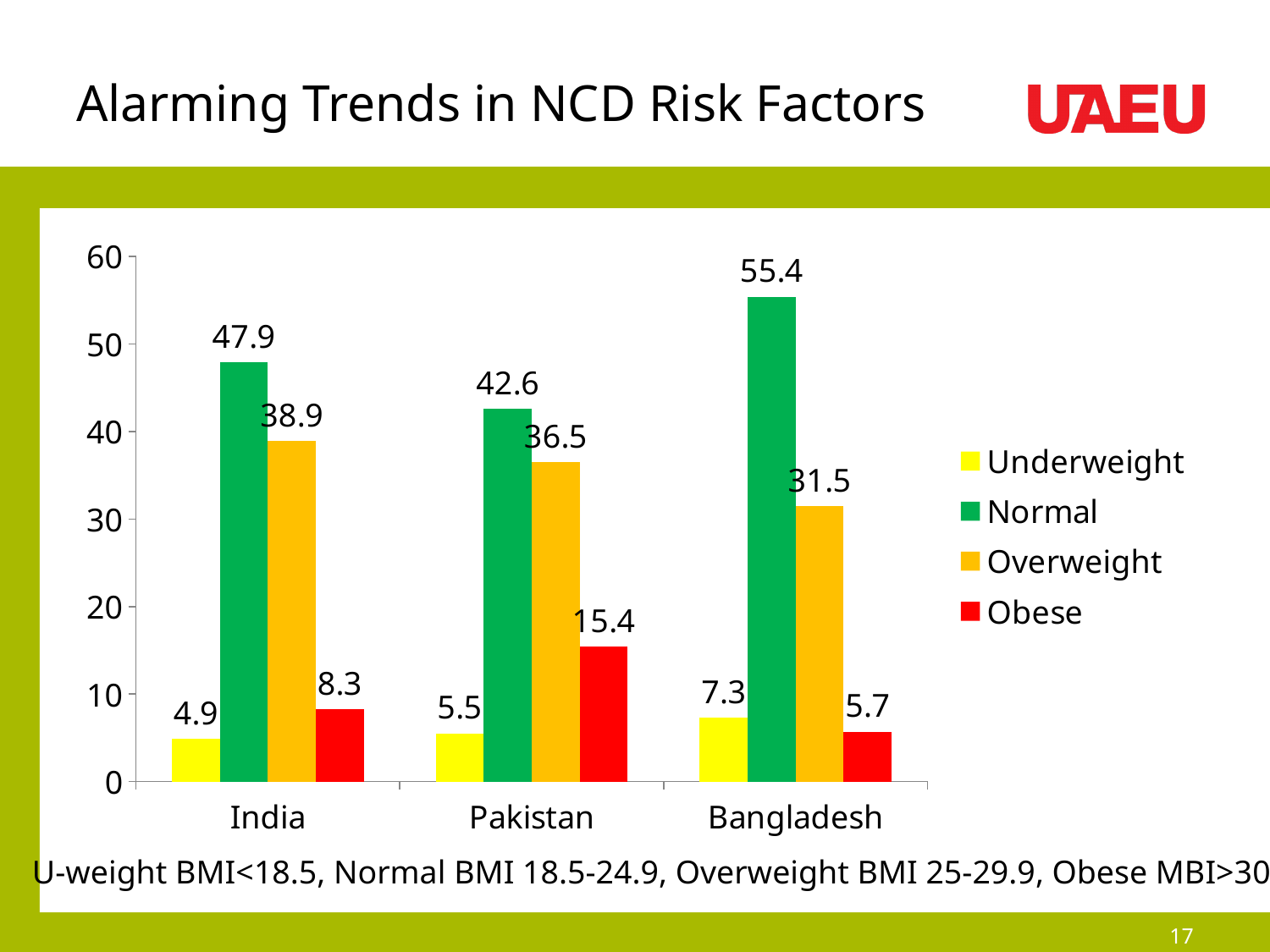
Which country has the lowest Obese value? Bangladesh What is the difference between the Normal values for Bangladesh and Pakistan? 12.8 How many series does the legend list? 4 What is the Obese value for Pakistan? 15.4 What kind of chart is shown on the slide? bar chart What is the Normal value for Bangladesh? 55.4 What is the Underweight value for India? 4.9 Which is larger, the Overweight value for Pakistan or the Overweight value for Bangladesh? Pakistan Which colour represents the Obese series in the legend? red Which country has the highest Overweight value? India How many countries are shown on the x axis? 3 Is the Normal value for India greater or less than 40? greater